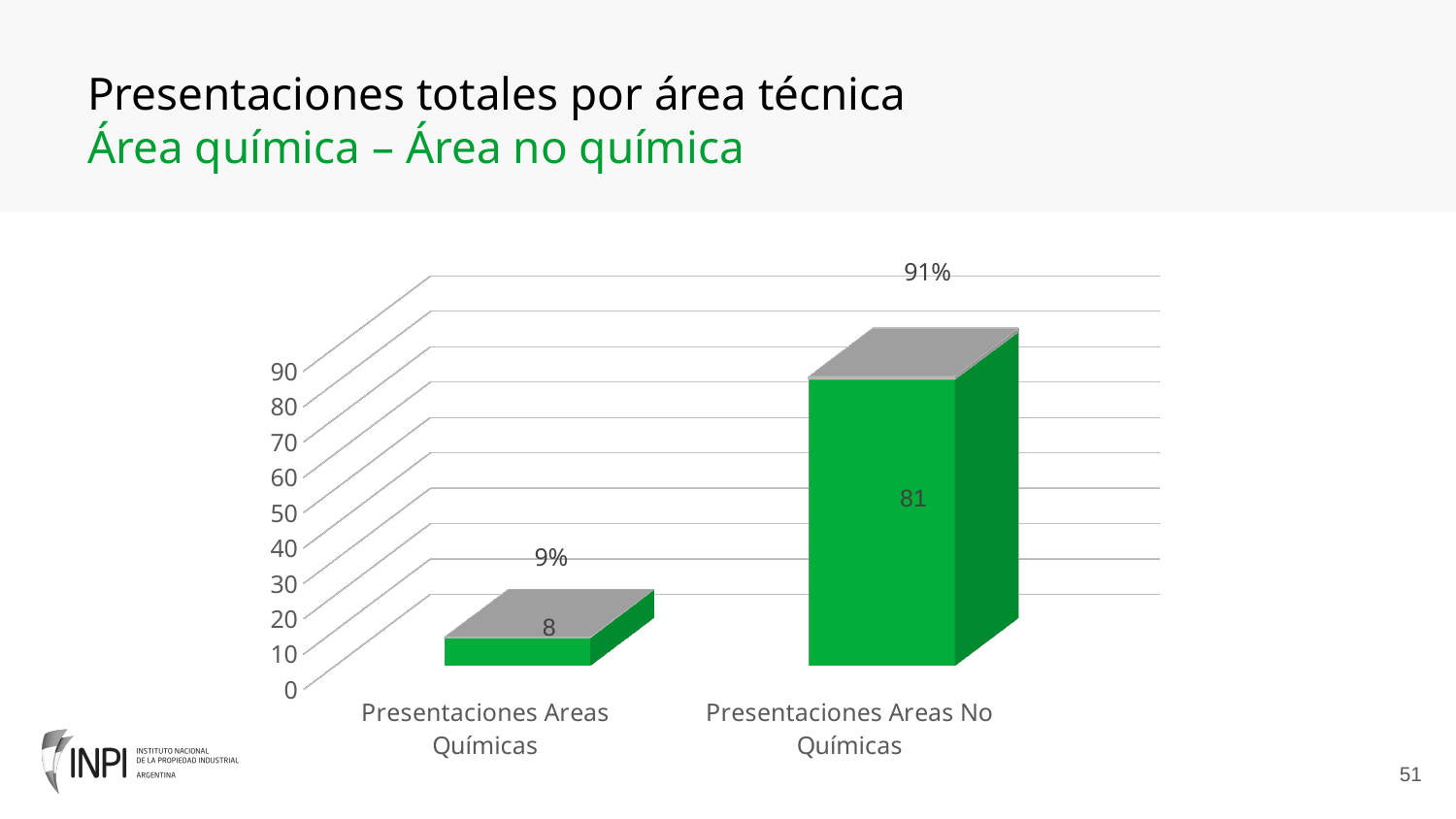
What is the value for Presentaciones Areas Químicas? 8 Which category has the lowest value? Presentaciones Areas Químicas What is the difference between the values for Presentaciones Areas No Químicas and Presentaciones Areas Químicas? 73 What is the total of the two values shown on the chart? 89 What kind of chart is shown on the slide? bar chart Which is larger, the value for Presentaciones Areas Químicas or for Presentaciones Areas No Químicas? Presentaciones Areas No Químicas Which category has the highest value? Presentaciones Areas No Químicas Is the value for Presentaciones Areas No Químicas greater or less than 50? greater What percentage label is shown above the Presentaciones Areas Químicas bar? 9% How many categories are shown on the chart? 2 What is the value for Presentaciones Areas No Químicas? 81 What percentage label is shown above the Presentaciones Areas No Químicas bar? 91%